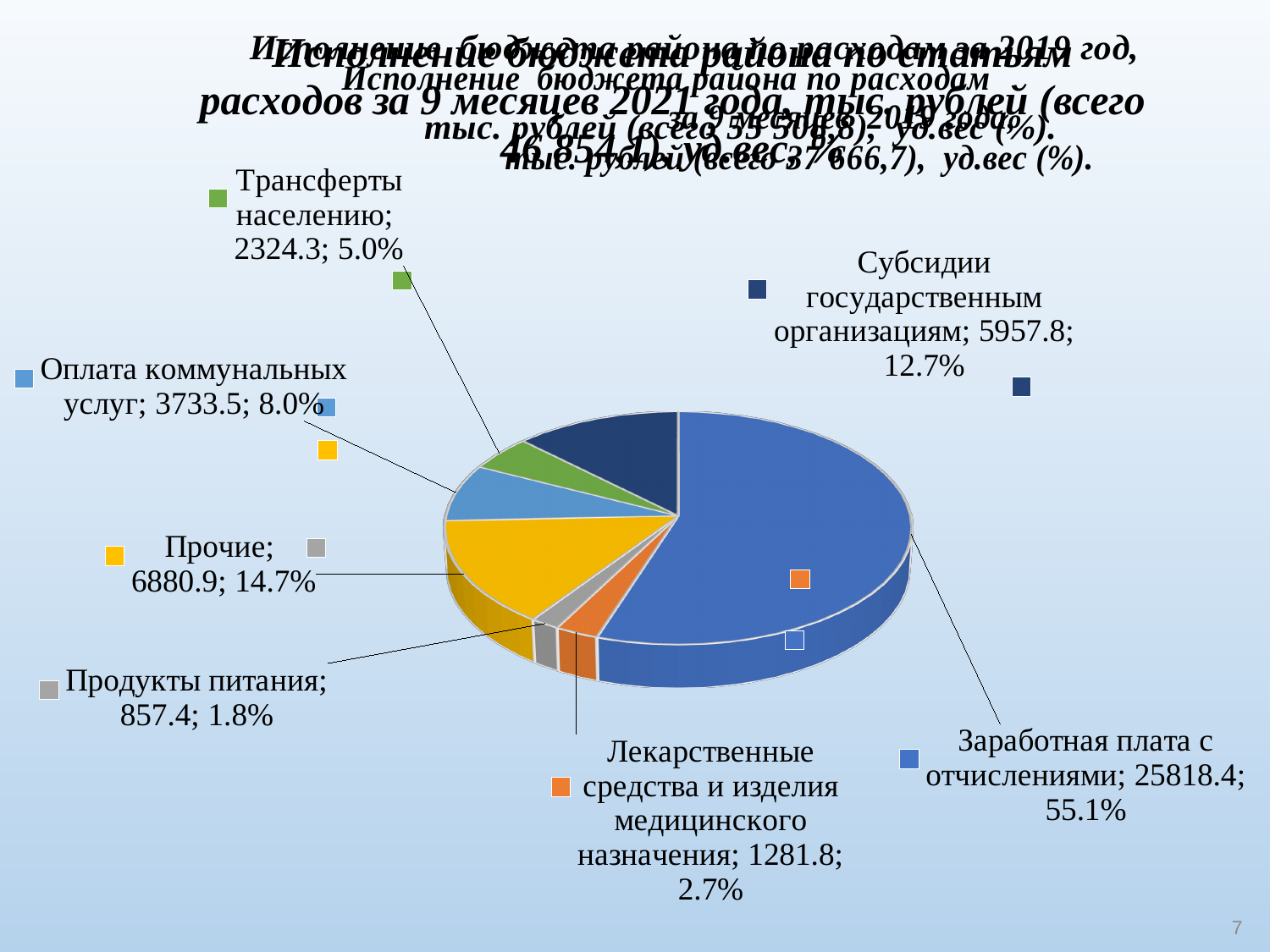
What is the value shown for "Заработная плата с отчислениями"? 25818.4 What share of the pie does "Субсидии государственным организациям" represent? 12.7% Which is larger: the value for "Трансферты населению" or the value for "Лекарственные средства и изделия медицинского назначения"? Трансферты населению What is the value shown for "Оплата коммунальных услуг"? 3733.5 What is the difference between the values for "Прочие" and "Субсидии государственным организациям"? 923.1 What kind of chart is shown on the slide? pie chart What colour is the slice for "Трансферты населению"? green Which category has the smallest slice of the pie? Продукты питания Which category has the largest slice of the pie? Заработная плата с отчислениями What share of the pie does "Прочие" represent? 14.7% How many categories (slices) does the pie chart have? 7 What share of the pie does "Продукты питания" represent? 1.8%